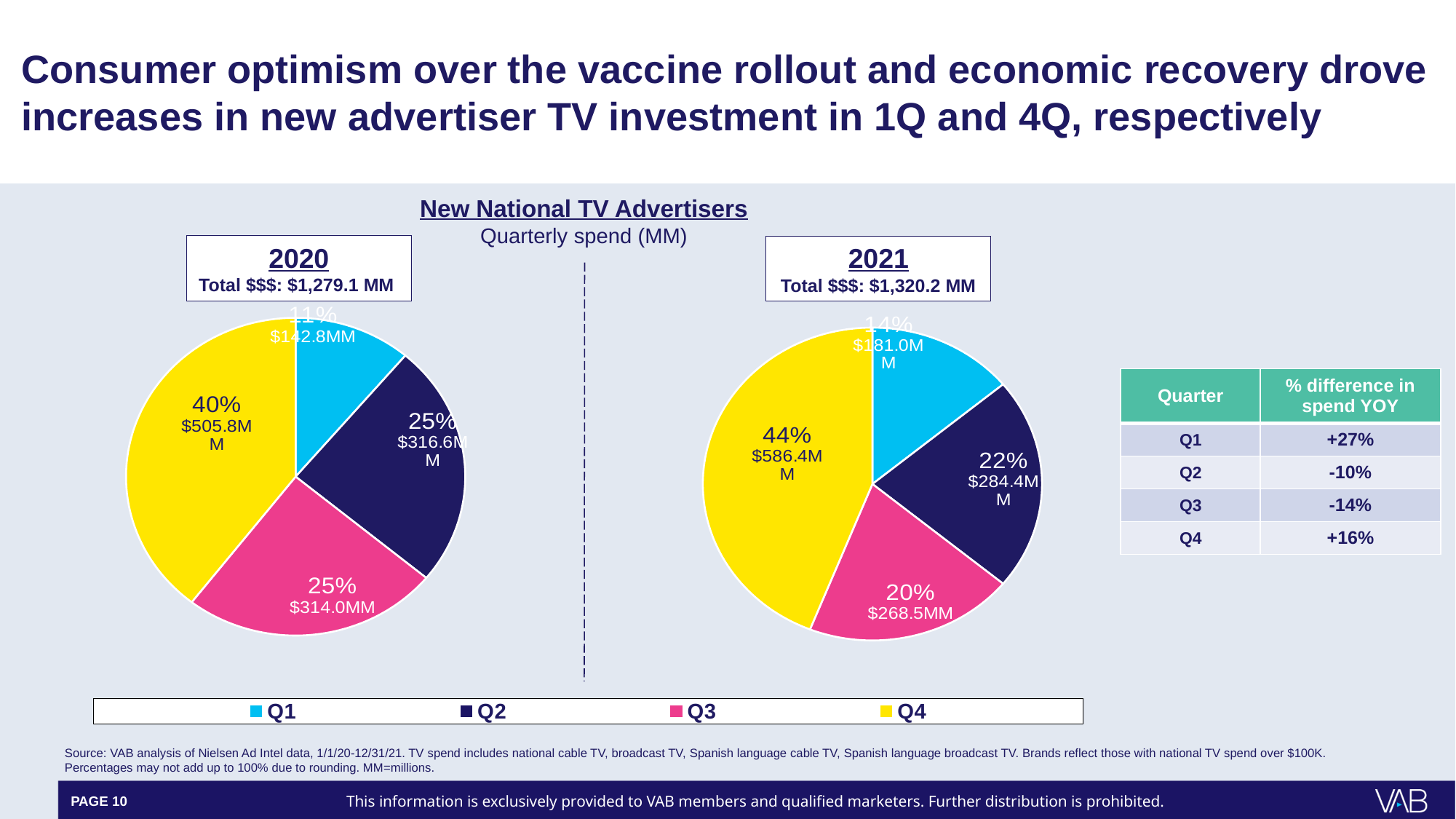
In the 2021 pie chart, what is the spend for Q3? $268.5MM In the 2021 pie chart, which is larger, the spend for Q2 or the spend for Q3? Q2 How many series does the legend list? 4 In the 2020 pie chart, what share of the pie does Q1 represent? 11% What is the total spend shown for 2021? $1,320.2 MM What kind of chart is used to show the 2020 quarterly spend? Pie chart In the 2020 pie chart, what is the spend for Q4? $505.8MM In the 2021 pie chart, what is the difference in spend between Q4 and Q1? $405.4MM In the 2020 pie chart, which quarter has the largest spend? Q4 In the 2021 pie chart, which quarter has the smallest spend? Q1 In the 2021 pie chart, what share of the pie does Q4 represent? 44% Which colour represents Q4 in the legend? Yellow